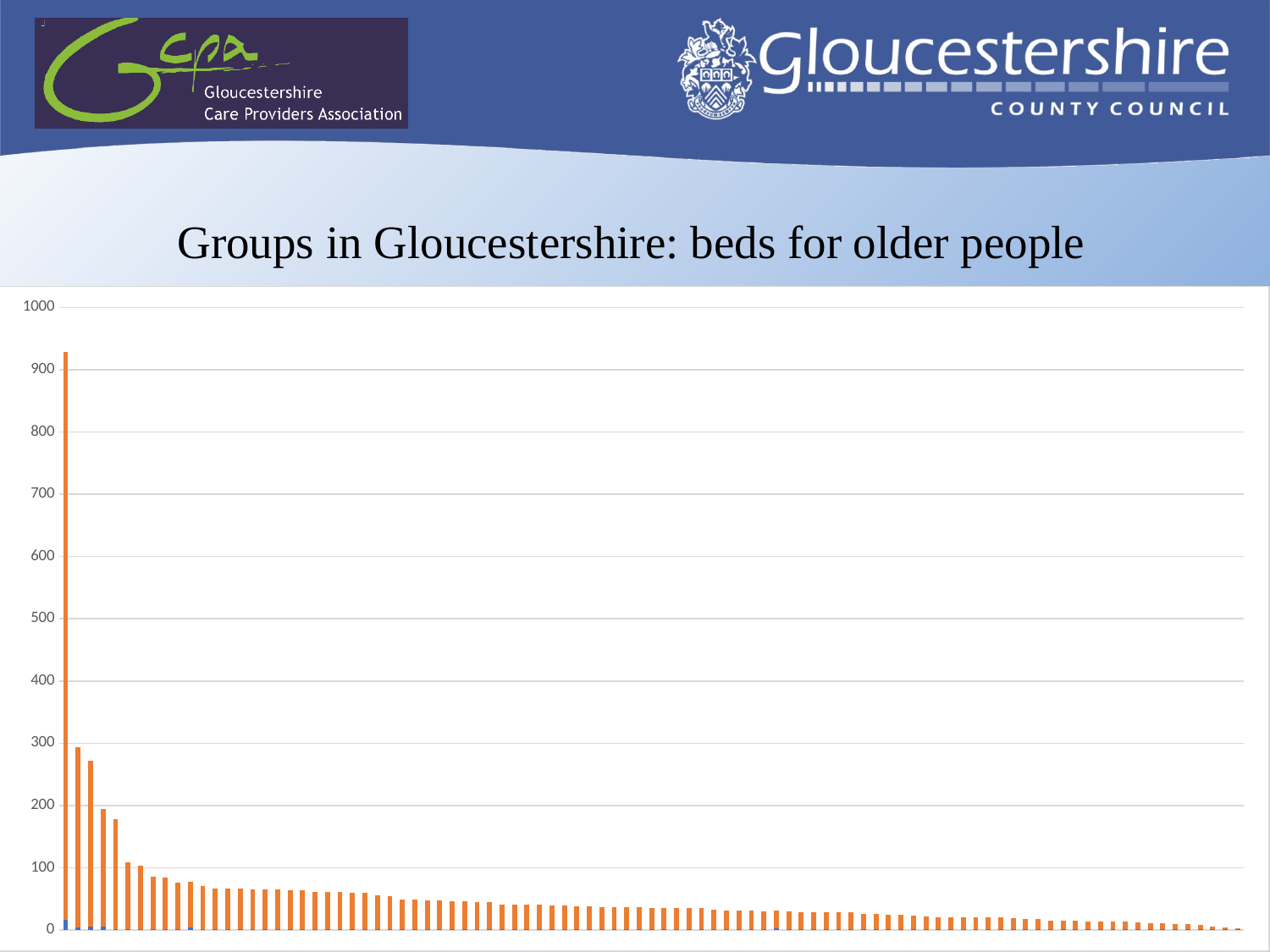
Do the bar values rise or fall moving from left to right along the x axis? fall Is the value for the third bar from the left greater or less than 200? greater Is the value for the second bar from the left greater or less than 400? less Is the value for the tallest (leftmost) bar greater or less than 900? greater What is the title of the chart? Groups in Gloucestershire: beds for older people What kind of chart is shown on the slide? bar chart What colour are the main bars in the chart? orange